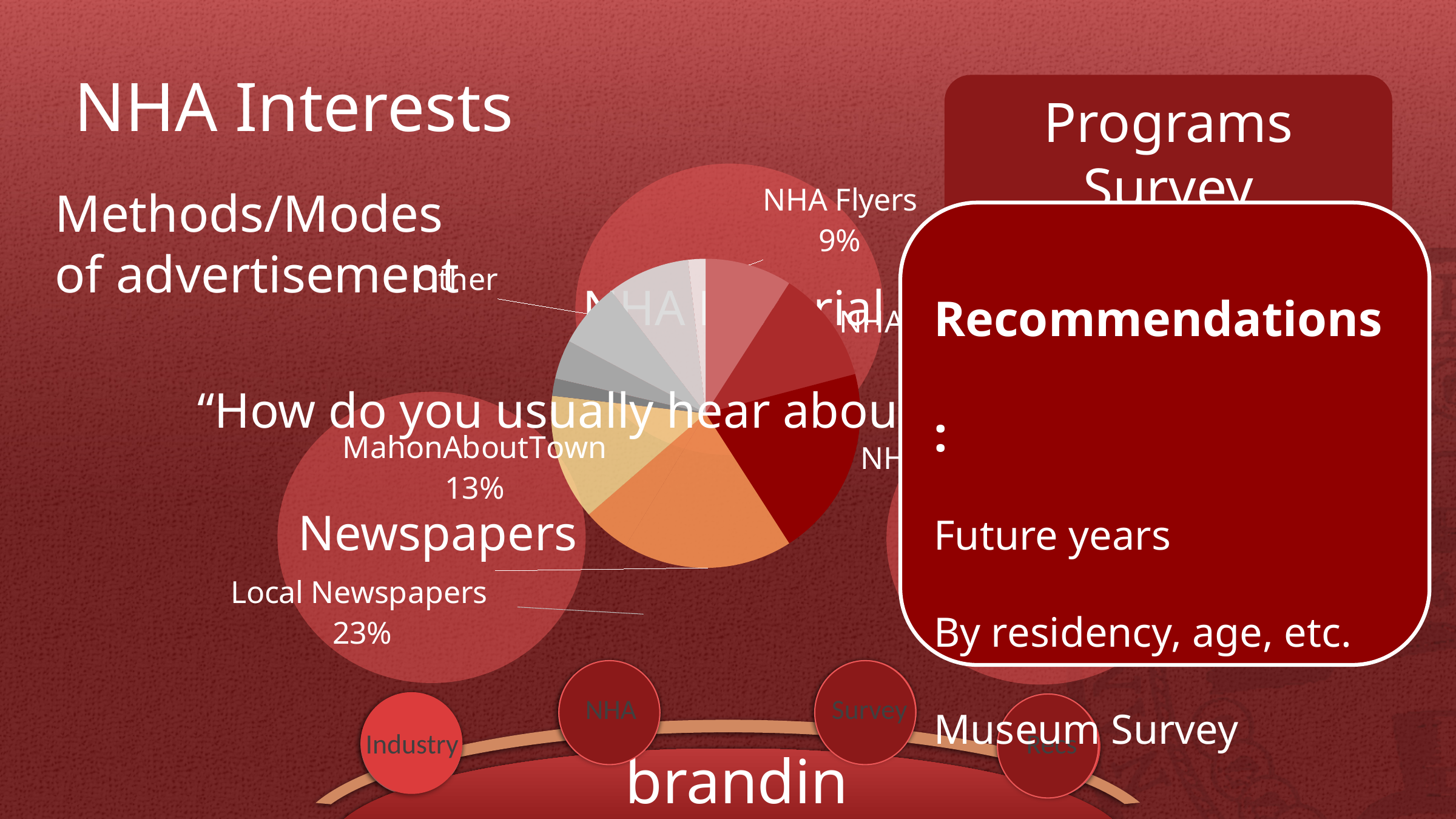
By how many percentage points does the MahonAboutTown share exceed the NHA Flyers share? 4 Which has the larger share in the pie chart, MahonAboutTown or NHA Flyers? MahonAboutTown What kind of chart is shown on the slide? pie chart What share of the pie chart is MahonAboutTown? 13% What share of the pie chart is NHA Flyers? 9% What share of the pie chart is Local Newspapers? 23% Among Local Newspapers, MahonAboutTown and NHA Flyers, which has the largest share in the pie chart? Local Newspapers What heading appears to the left of the pie chart describing what it shows? Methods/Modes of advertisement By how many percentage points does the Local Newspapers share exceed the MahonAboutTown share? 10 Among Local Newspapers, MahonAboutTown and NHA Flyers, which has the smallest share in the pie chart? NHA Flyers By how many percentage points does the Local Newspapers share exceed the NHA Flyers share? 14 Which has the larger share in the pie chart, Local Newspapers or MahonAboutTown? Local Newspapers